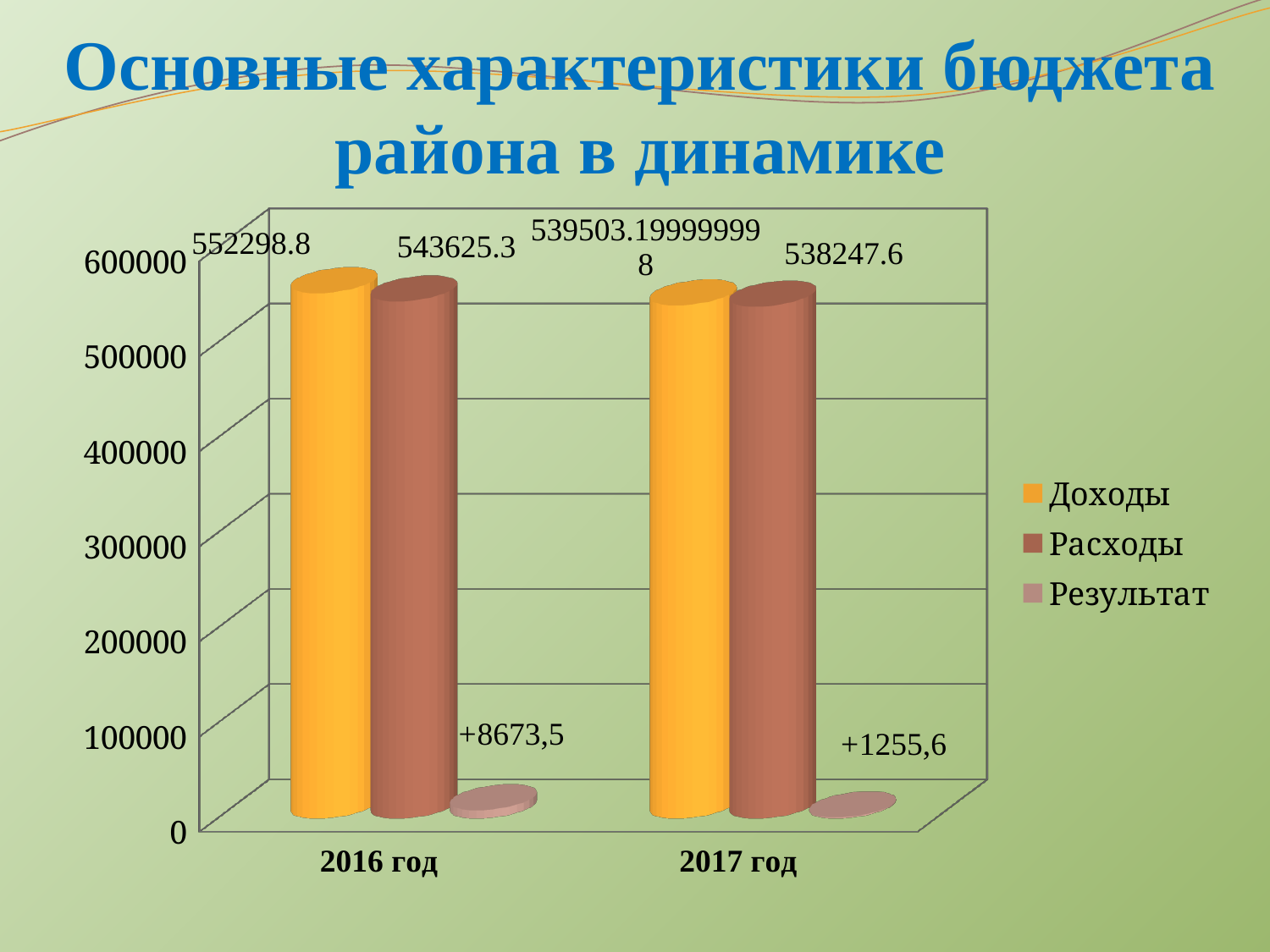
What is the difference between Расходы in 2016 год and Расходы in 2017 год? 5377.7 What is the value of Результат for 2016 год? +8673,5 In which year is Результат lowest? 2017 год What is the value of Расходы for 2016 год? 543625.3 Is the value of Доходы for 2016 год greater or less than 500000? greater What is the value of Результат for 2017 год? +1255,6 What is the value of Расходы for 2017 год? 538247.6 How many series does the legend list? 3 Which is larger for 2016 год, Доходы or Расходы? Доходы What is the value of Доходы for 2016 год? 552298.8 Do the Расходы values rise or fall from 2016 год to 2017 год? fall In which year is Доходы higher? 2016 год